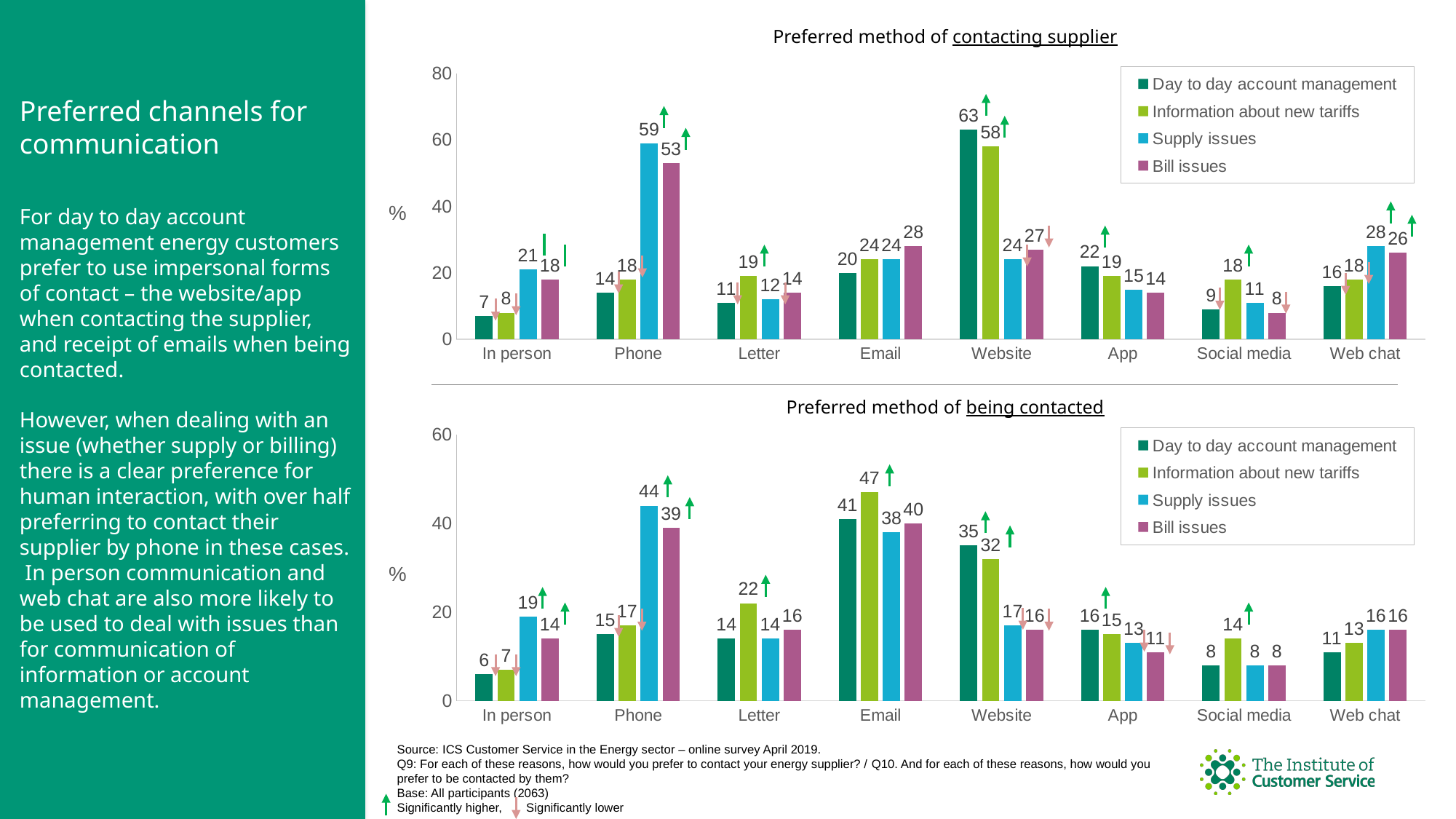
How many categories are shown on the x axis of the 'Preferred method of being contacted' chart? 8 In the 'Preferred method of contacting supplier' chart, which category has the highest value for Bill issues? Phone In the 'Preferred method of contacting supplier' chart, what is the difference between the Supply issues and Day to day account management values for Phone? 45 How many series does the legend of the 'Preferred method of contacting supplier' chart list? 4 In the 'Preferred method of being contacted' chart, what is the difference between the Supply issues and Bill issues values for Phone? 5 In the 'Preferred method of contacting supplier' chart, what is the value for Supply issues for Phone? 59 What type of chart is the 'Preferred method of contacting supplier' chart? Bar chart In the 'Preferred method of contacting supplier' chart, which category has the lowest value for Day to day account management? In person In the 'Preferred method of being contacted' chart, which is larger for Website: Day to day account management or Supply issues? Day to day account management In the 'Preferred method of being contacted' chart, which category has the highest value for Day to day account management? Email In the 'Preferred method of contacting supplier' chart, what is the value for Day to day account management for Website? 63 In the 'Preferred method of being contacted' chart, what is the value for Information about new tariffs for Email? 47